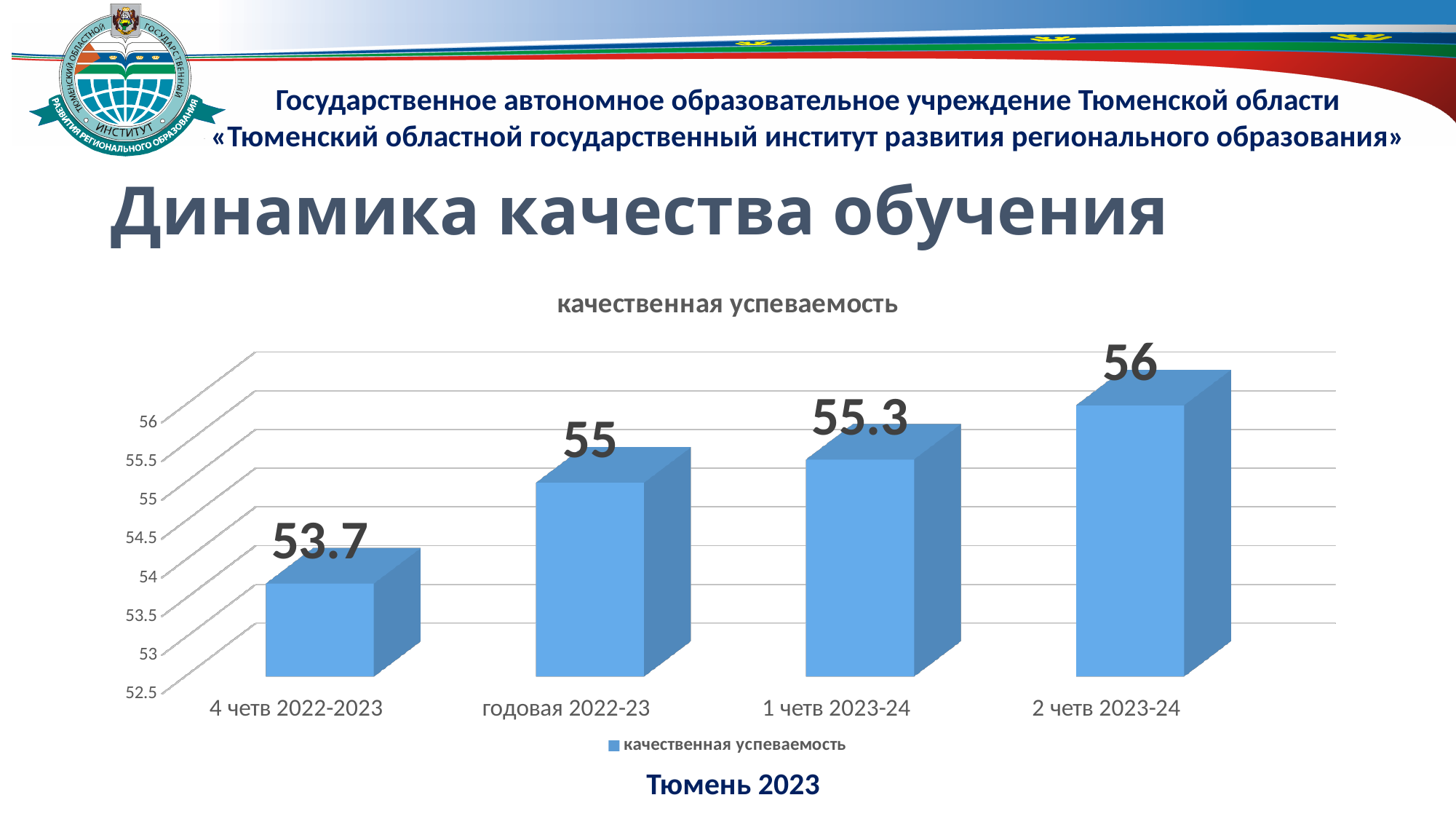
How many categories are shown on the x axis? 4 Which category has the lowest value? 4 четв 2022-2023 Do the values rise or fall from left to right along the x axis? rise What kind of chart is shown? bar chart What is the value for 4 четв 2022-2023? 53.7 What is the difference between the values for 2 четв 2023-24 and 4 четв 2022-2023? 2.3 Which category has the highest value? 2 четв 2023-24 Which is larger, the value for годовая 2022-23 or the value for 1 четв 2023-24? 1 четв 2023-24 What is the value for 1 четв 2023-24? 55.3 How many series does the legend list? 1 What is the value for годовая 2022-23? 55 What is the value for 2 четв 2023-24? 56